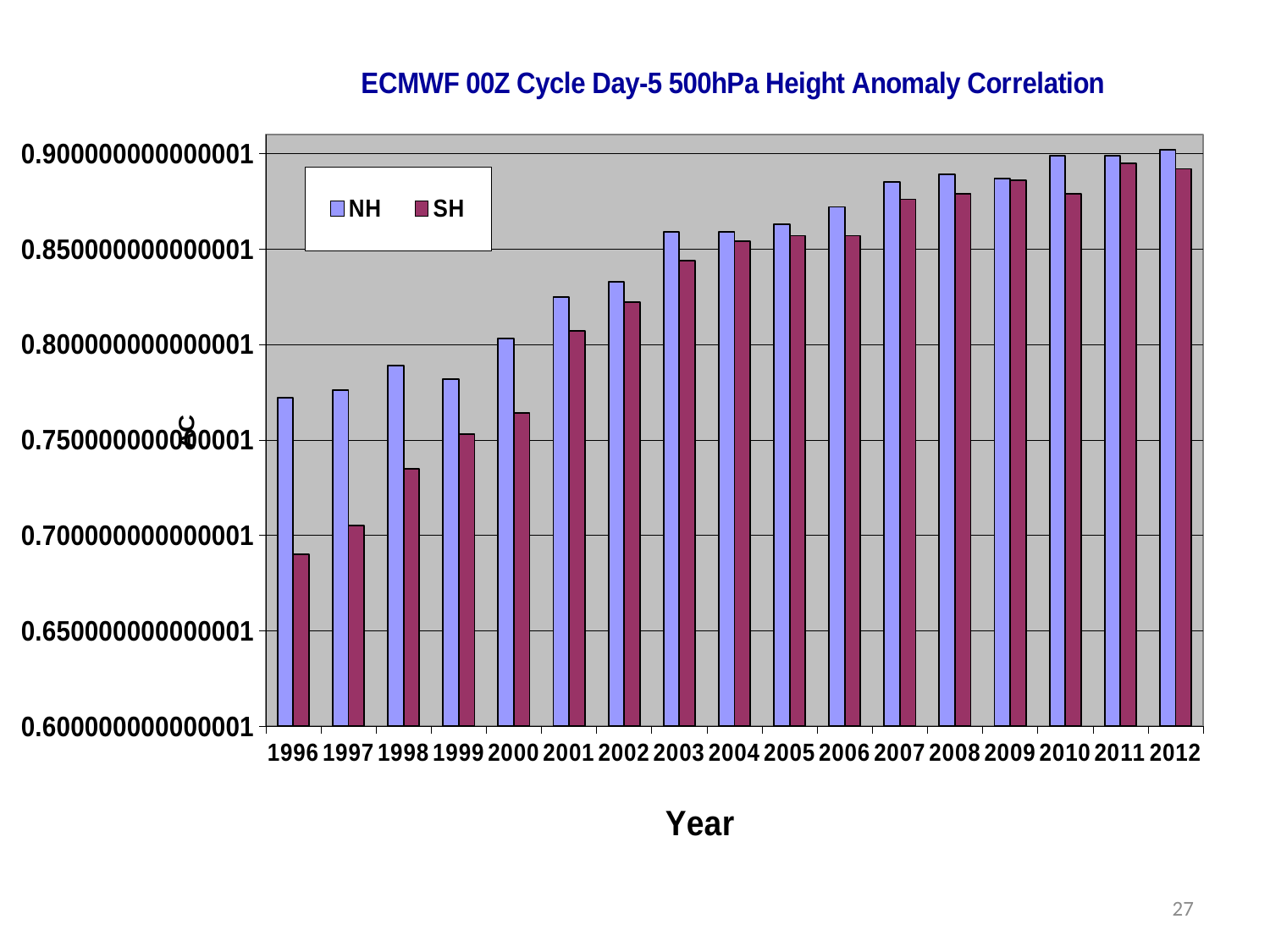
Is the SH value for 1996 greater or less than 0.70? less Is the NH value for 1996 greater or less than 0.75? greater Is the SH value for 2003 greater or less than 0.85? less What kind of chart is shown on the slide? bar chart Which year has the lowest SH value? 1996 How many series does the legend list? 2 Do the NH values generally rise or fall from 1996 to 2012? rise In 2002, which is larger, the NH value or the SH value? NH How many years are shown along the x axis? 17